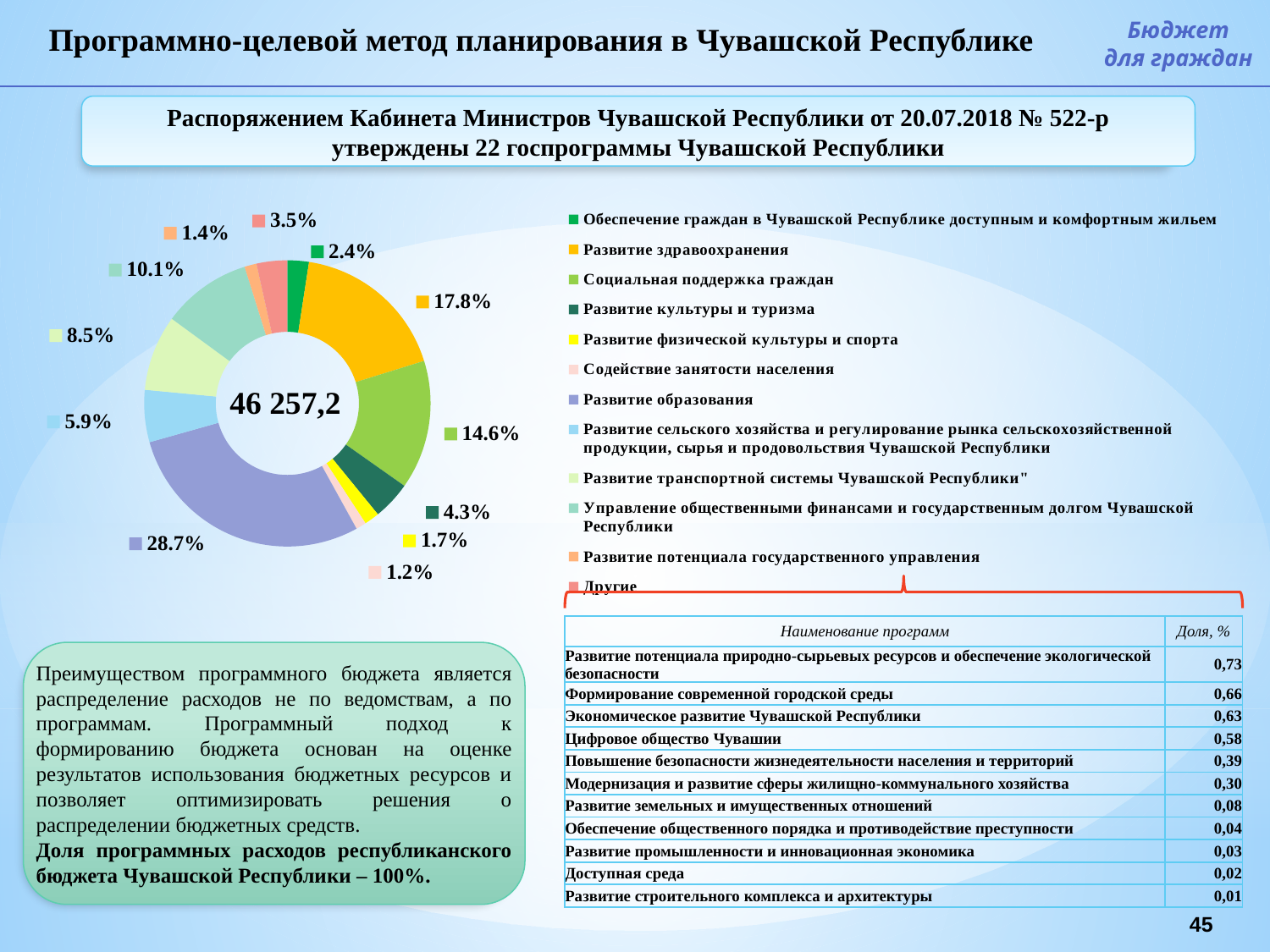
What type of chart is shown on the slide? doughnut (pie) chart Which program has the largest slice in the chart? Развитие образования What is the difference in percentage points between the slices for Развитие образования and Развитие здравоохранения? 10.9 What share does the slice for Социальная поддержка граждан have? 14.6% What share does the slice for Управление общественными финансами и государственным долгом Чувашской Республики have? 10.1% What share does the slice for Другие have? 3.5% What number is printed in the centre of the doughnut chart? 46 257,2 What share does the slice for Развитие здравоохранения have? 17.8% What share does the slice for Развитие образования have? 28.7% How many entries does the chart legend list? 12 Which slice is larger: Развитие транспортной системы Чувашской Республики or Развитие сельского хозяйства? Развитие транспортной системы Чувашской Республики Which program has the smallest slice in the chart? Содействие занятости населения